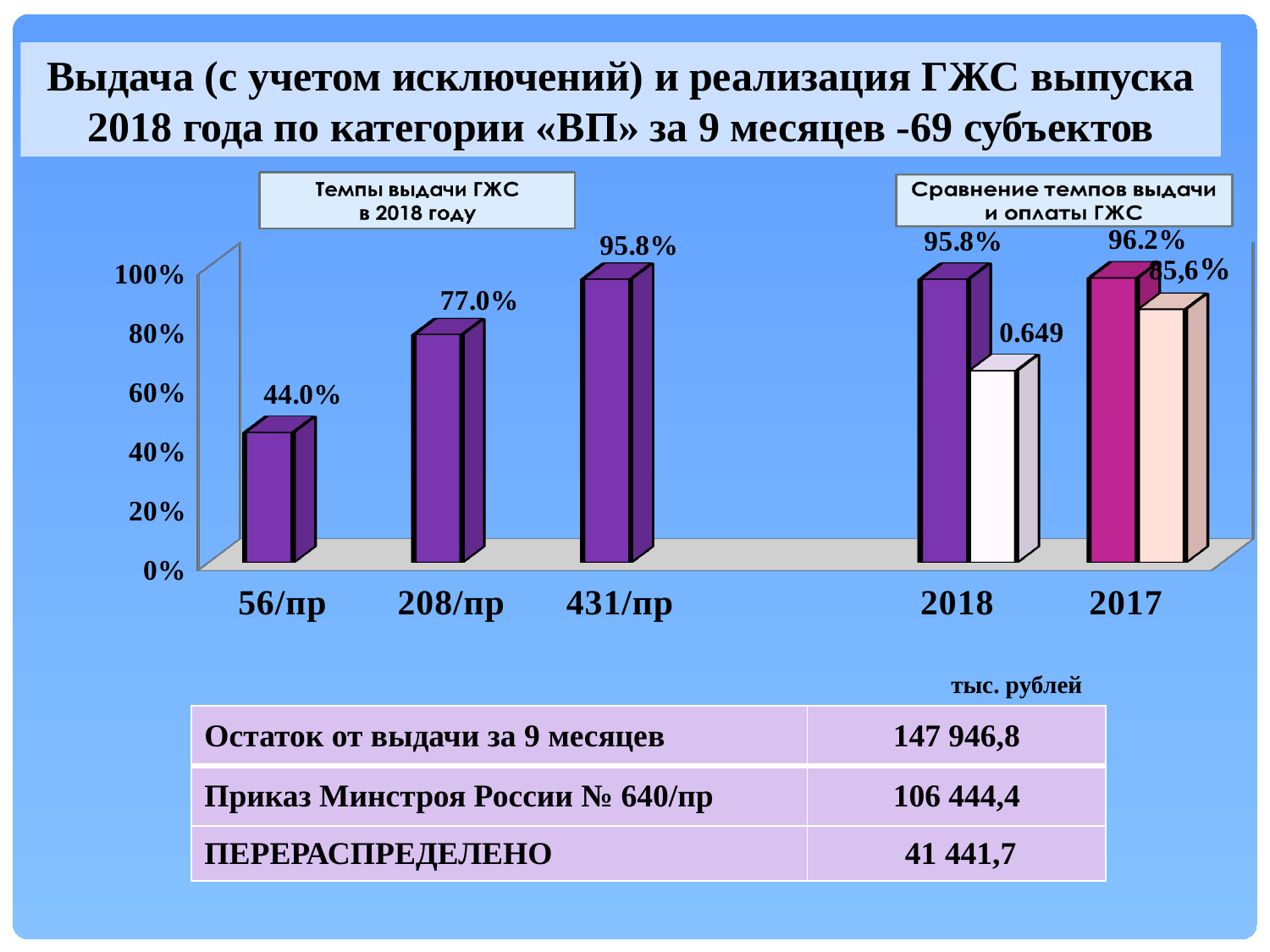
In the chart 'Темпы выдачи ГЖС в 2018 году', do the values rise or fall from 56/пр to 431/пр? rise In the chart 'Сравнение темпов выдачи и оплаты ГЖС', what is the value of the taller (magenta) bar for 2017? 96.2% In the chart 'Темпы выдачи ГЖС в 2018 году', how many categories are shown? 3 In the chart 'Темпы выдачи ГЖС в 2018 году', what is the value for 431/пр? 95.8% In the chart 'Темпы выдачи ГЖС в 2018 году', which category has the highest value? 431/пр In the chart 'Темпы выдачи ГЖС в 2018 году', what is the value for 208/пр? 77.0% In the chart 'Темпы выдачи ГЖС в 2018 году', which category has the lowest value? 56/пр In the chart 'Сравнение темпов выдачи и оплаты ГЖС', is the value of the shorter (light) bar for 2018 greater or less than 80%? less In the chart 'Темпы выдачи ГЖС в 2018 году', what is the difference between the values for 208/пр and 56/пр? 33.0% In the chart 'Темпы выдачи ГЖС в 2018 году', what is the value for 56/пр? 44.0% What kind of chart is shown on the slide? bar chart In the chart 'Сравнение темпов выдачи и оплаты ГЖС', what is the value of the taller (purple) bar for 2018? 95.8%